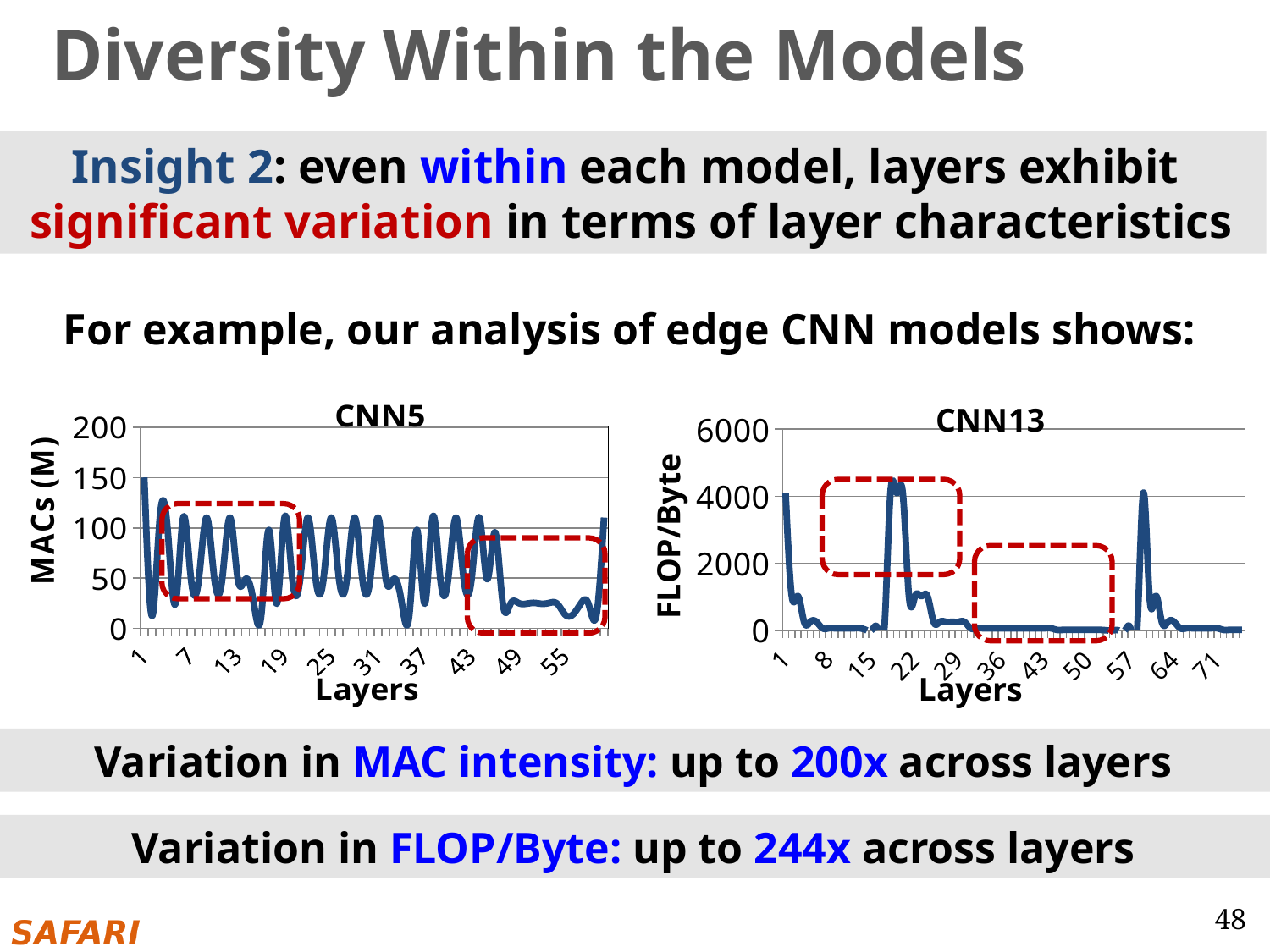
In the CNN13 chart, is the value at layer 8 greater or less than 2000? less What is the y-axis label of the CNN13 chart? FLOP/Byte In the CNN13 chart, is the value at layer 43 greater or less than 2000? less What kind of chart is the CNN13 chart? line chart In the CNN5 chart, is the value at layer 1 greater or less than 100? greater How many charts are shown on the slide? 2 In the CNN5 chart, which layer has the highest MACs value? 1 What kind of chart is the CNN5 chart? line chart In the CNN13 chart, what is the highest value shown on the y-axis? 6000 In the CNN5 chart, is the value at layer 1 larger than the value at layer 49? yes What is the y-axis label of the CNN5 chart? MACs (M)